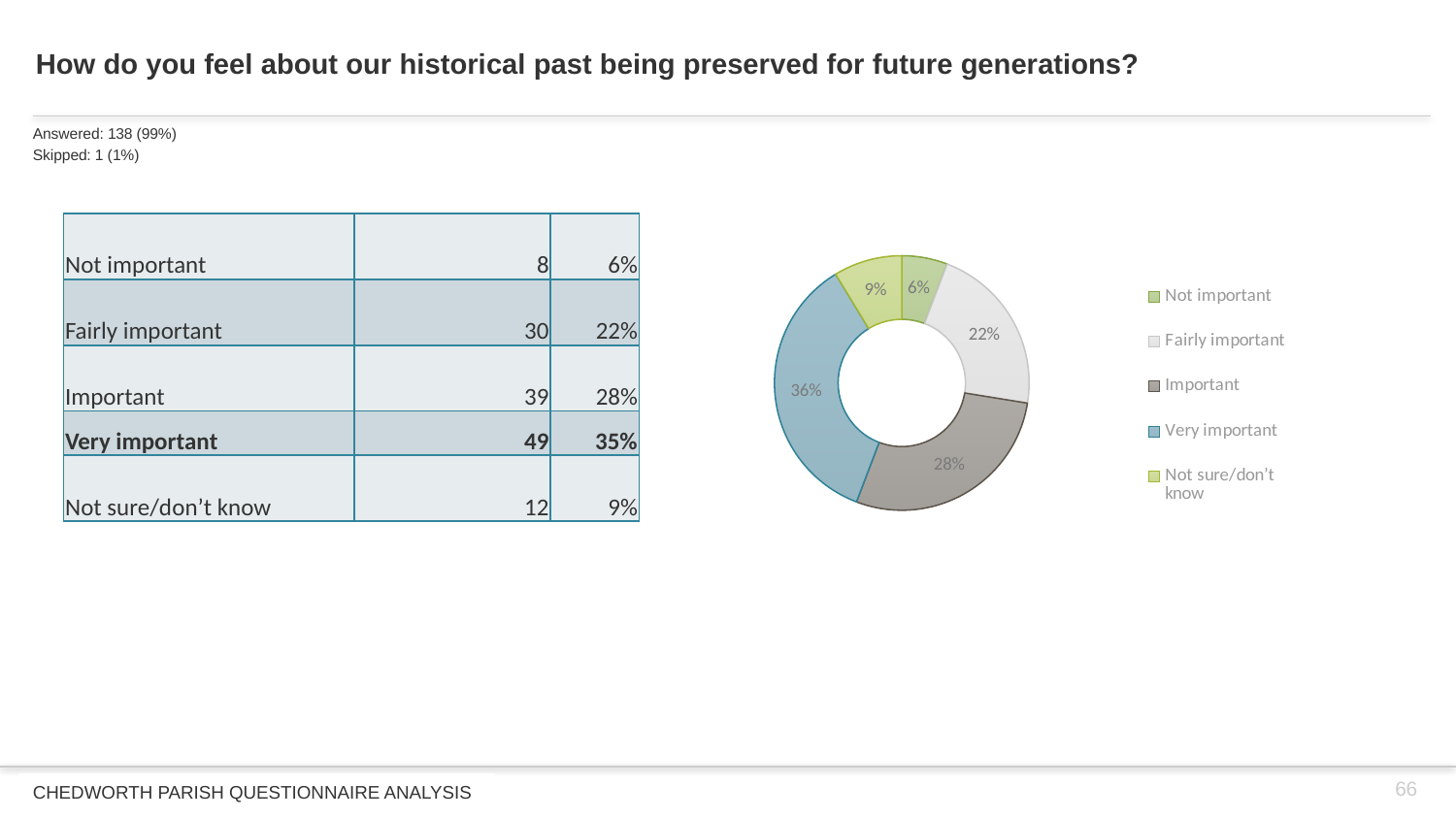
What percentage does the chart show for Fairly important? 22% What is the difference in percentage points between the chart's shares for Very important and Not important? 30 Which is larger in the chart, the share for Important or the share for Fairly important? Important How many categories does the chart's legend list? 5 What percentage does the chart show for Not sure/don't know? 9% What percentage does the chart show for Important? 28% What colour is the Very important segment in the chart? Blue What percentage does the chart show for Not important? 6% What percentage does the chart show for Very important? 36% What kind of chart is shown on the slide? Doughnut chart Which category has the largest share in the chart? Very important Which category has the smallest share in the chart? Not important